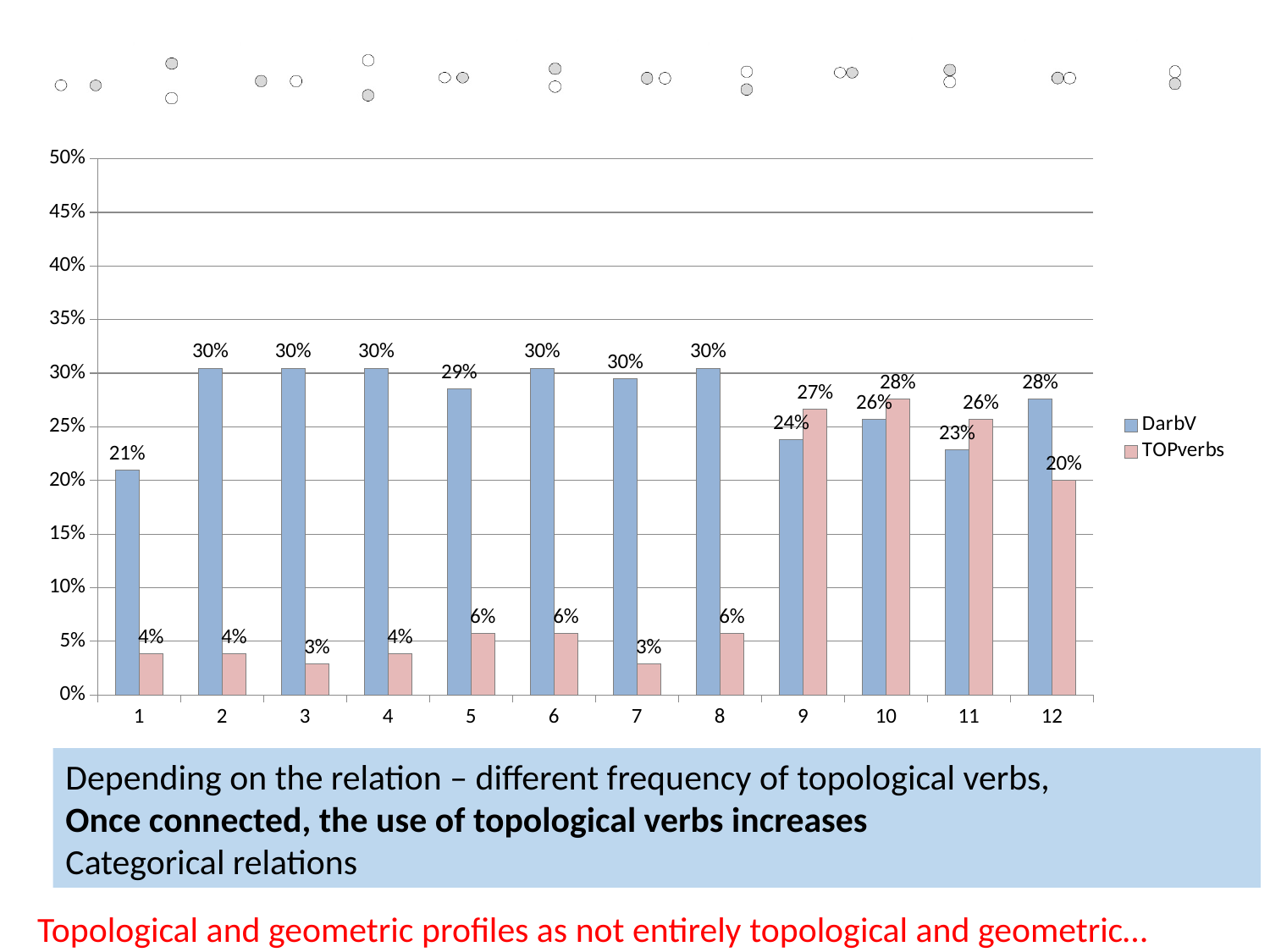
What is the DarbV value for category 1? 21% Which category has the lowest DarbV value? 1 What are the two series named in the legend? DarbV and TOPverbs What kind of chart is shown on the slide? Bar chart Which is larger for category 11, DarbV or TOPverbs? TOPverbs Which category has the highest TOPverbs value? 10 What is the difference between the DarbV and TOPverbs values for category 9? 3% What is the TOPverbs value for category 12? 20% How many categories are shown on the x axis? 12 How many series does the legend list? 2 What is the TOPverbs value for category 10? 28% Which is larger for category 5, DarbV or TOPverbs? DarbV